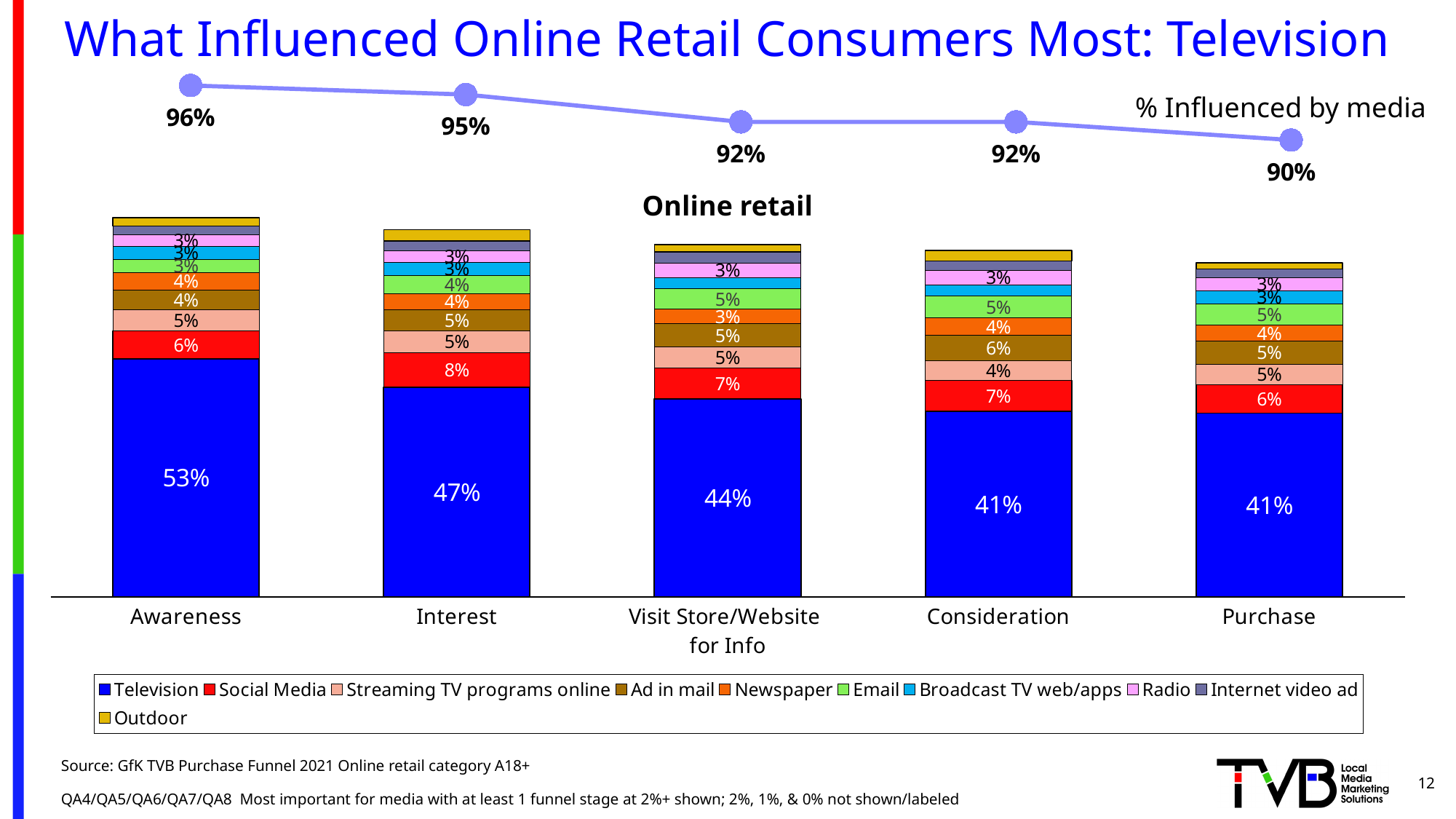
In the 'Online retail' stacked bar chart, what is the Television value for Visit Store/Website for Info? 44% What kind of chart is the 'Online retail' chart? stacked bar chart How many series does the legend of the 'Online retail' chart list? 10 In the 'Online retail' stacked bar chart, which funnel stage has the highest Television value? Awareness In the 'Online retail' stacked bar chart, what is the Television value for Awareness? 53% In the 'Online retail' stacked bar chart, what is the Ad in mail value for Consideration? 6% In the 'Online retail' stacked bar chart, what is the Social Media value for Interest? 8% In the line chart at the top, how many data points are plotted? 5 In the line chart at the top, what is the % influenced by media at the Purchase stage? 90% In the 'Online retail' stacked bar chart, what is the difference between the Television value for Awareness and for Purchase? 12 percentage points In the line chart at the top, do the values rise or fall from left to right? fall In the line chart at the top, what is the % influenced by media at the Awareness stage? 96%